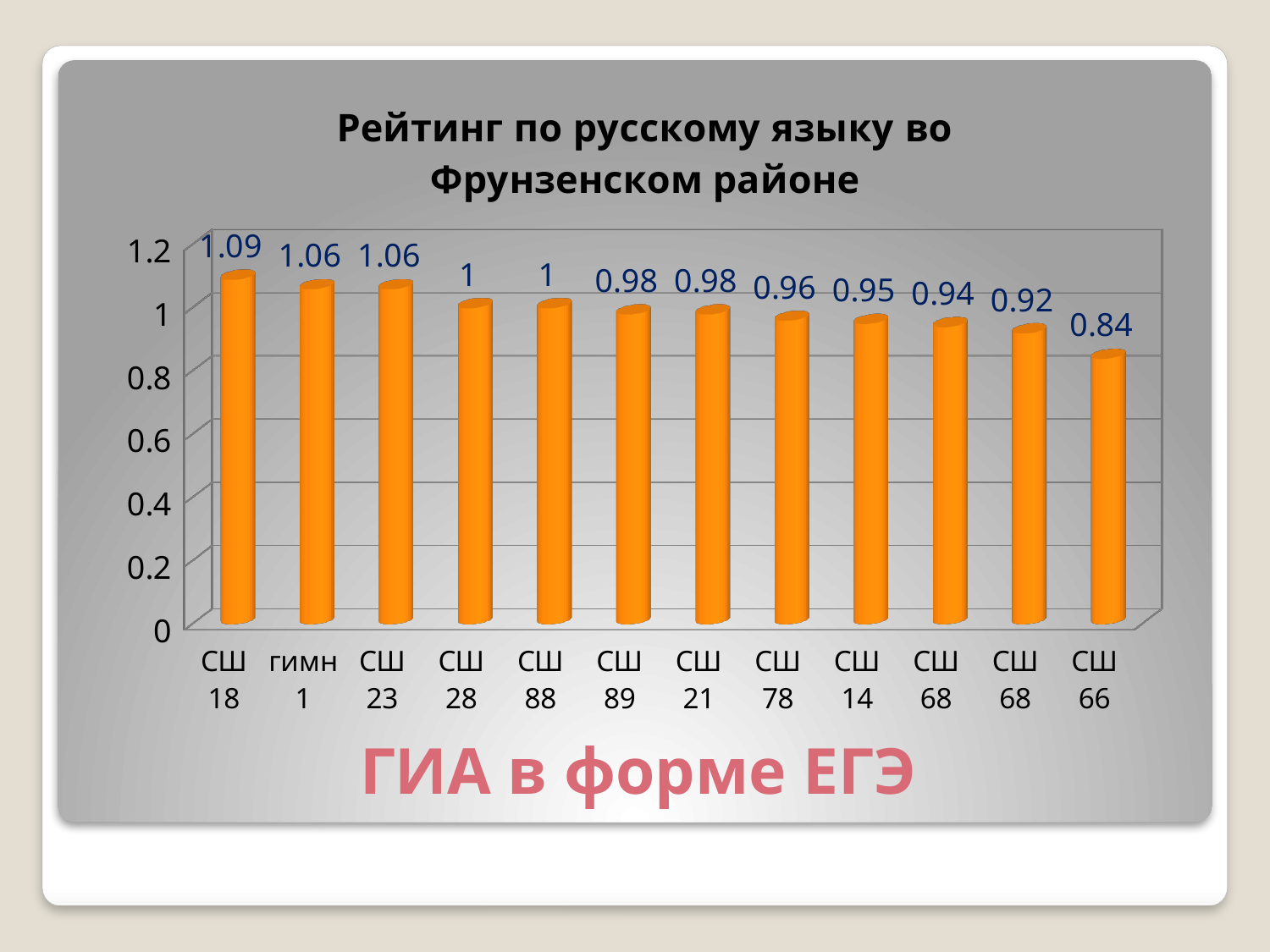
Is the value for СШ 66 greater or less than 1? less What is the value for СШ 78? 0.96 Which is larger, the value for СШ 23 or the value for СШ 14? СШ 23 How many categories are shown on the x axis? 12 What is the value for СШ 66? 0.84 What is the value for СШ 18? 1.09 Do the values rise or fall from left to right along the x axis? fall What kind of chart is shown on the slide? bar chart What is the value for гимн 1? 1.06 What is the difference between the values for СШ 18 and СШ 66? 0.25 Which category has the lowest value? СШ 66 Which category has the highest value? СШ 18